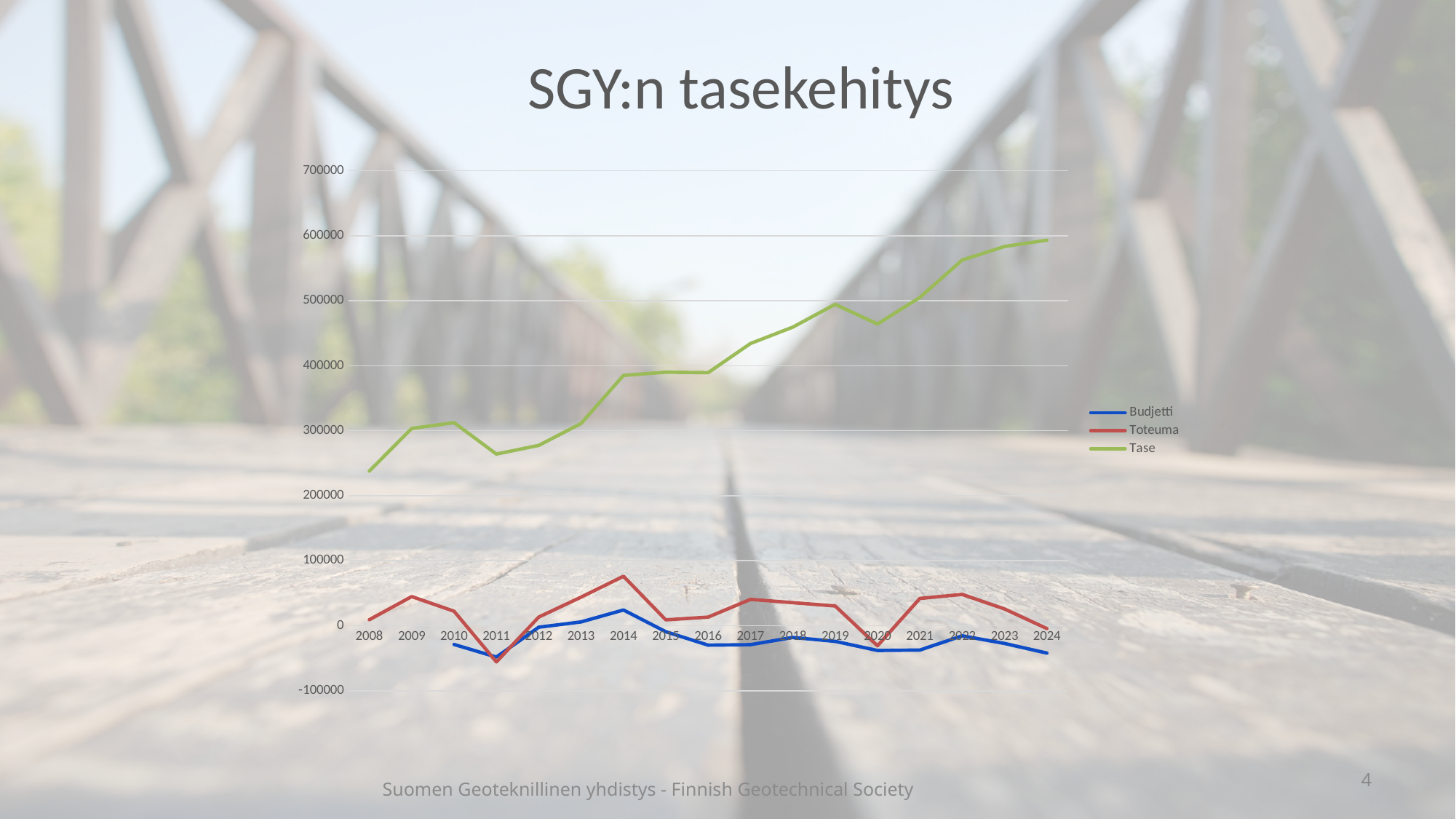
In which year is the Tase series at its highest? 2024 Which series are listed in the legend? Budjetti, Toteuma, Tase Which series has the larger value in 2024, Tase or Toteuma? Tase Is the value for Toteuma in 2014 greater or less than 100000? less Is the value for Tase in 2011 greater or less than 300000? less Does the Tase series generally rise or fall from 2008 to 2024? rise How many years are shown on the x axis? 17 What is the title of the chart? SGY:n tasekehitys How many series does the legend list? 3 What kind of chart is shown on the slide? line chart In which year is the Tase series at its lowest? 2008 Is the value for Tase in 2024 greater or less than 500000? greater